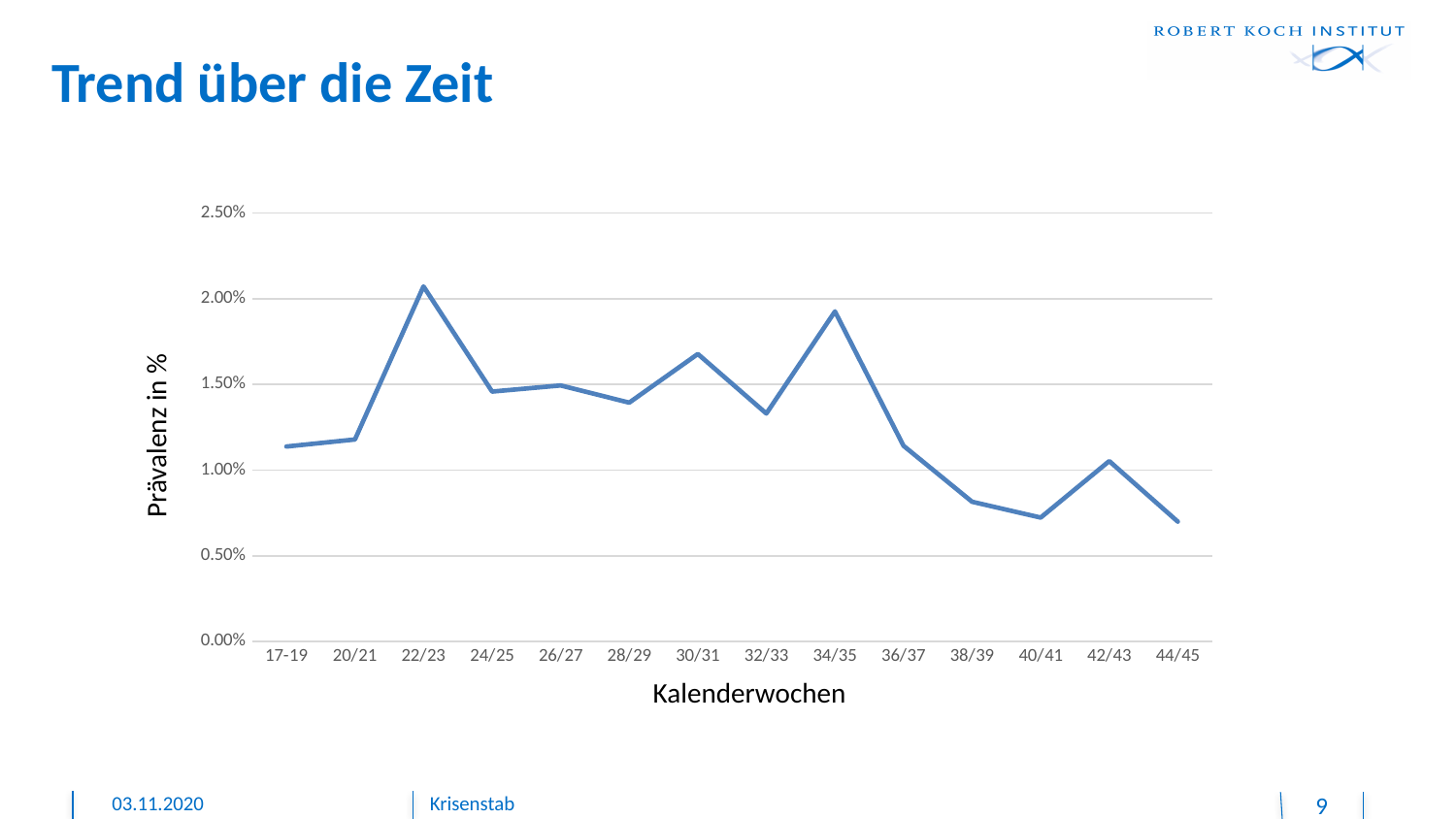
Is the value for 17-19 greater or less than 1.00%? greater Which is larger, the value for 30/31 or the value for 32/33? 30/31 Does the prevalence rise or fall from 34/35 to 40/41? fall Is the value for 30/31 greater or less than 1.50%? greater Is the value for 44/45 greater or less than 1.00%? less What is the label of the x axis? Kalenderwochen Which calendar-week period has the highest prevalence? 22/23 Which is larger, the value for 22/23 or the value for 34/35? 22/23 What kind of chart is shown on the slide? line chart How many calendar-week points are plotted on the x axis? 14